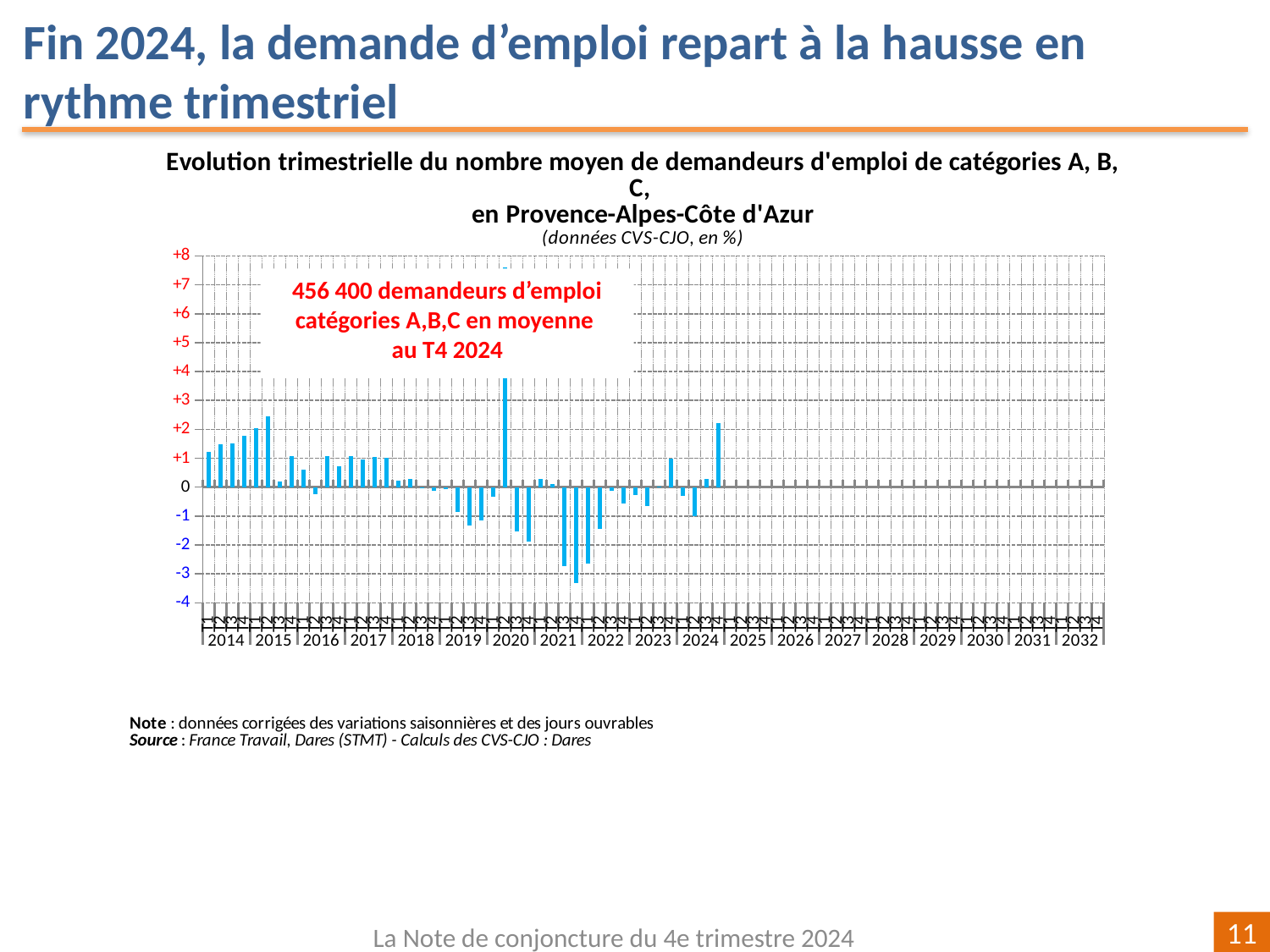
How many year labels appear along the x axis of the chart? 19 In which year does the chart's lowest bar occur? 2021 Is the value of the last bar of 2024 greater or less than +3? less In what unit are the chart's data expressed, according to the subtitle? % Is the value of the tallest bar in 2020 greater or less than +4? greater Is the tallest bar in 2020 higher than the tallest bar in 2015? yes In which year does the chart's highest bar occur? 2020 According to the text box on the chart, how many demandeurs d'emploi catégories A,B,C were there on average in T4 2024? 456 400 What kind of chart is shown on the slide? bar chart Is the value of the tallest bar in 2020 greater or less than +3? greater